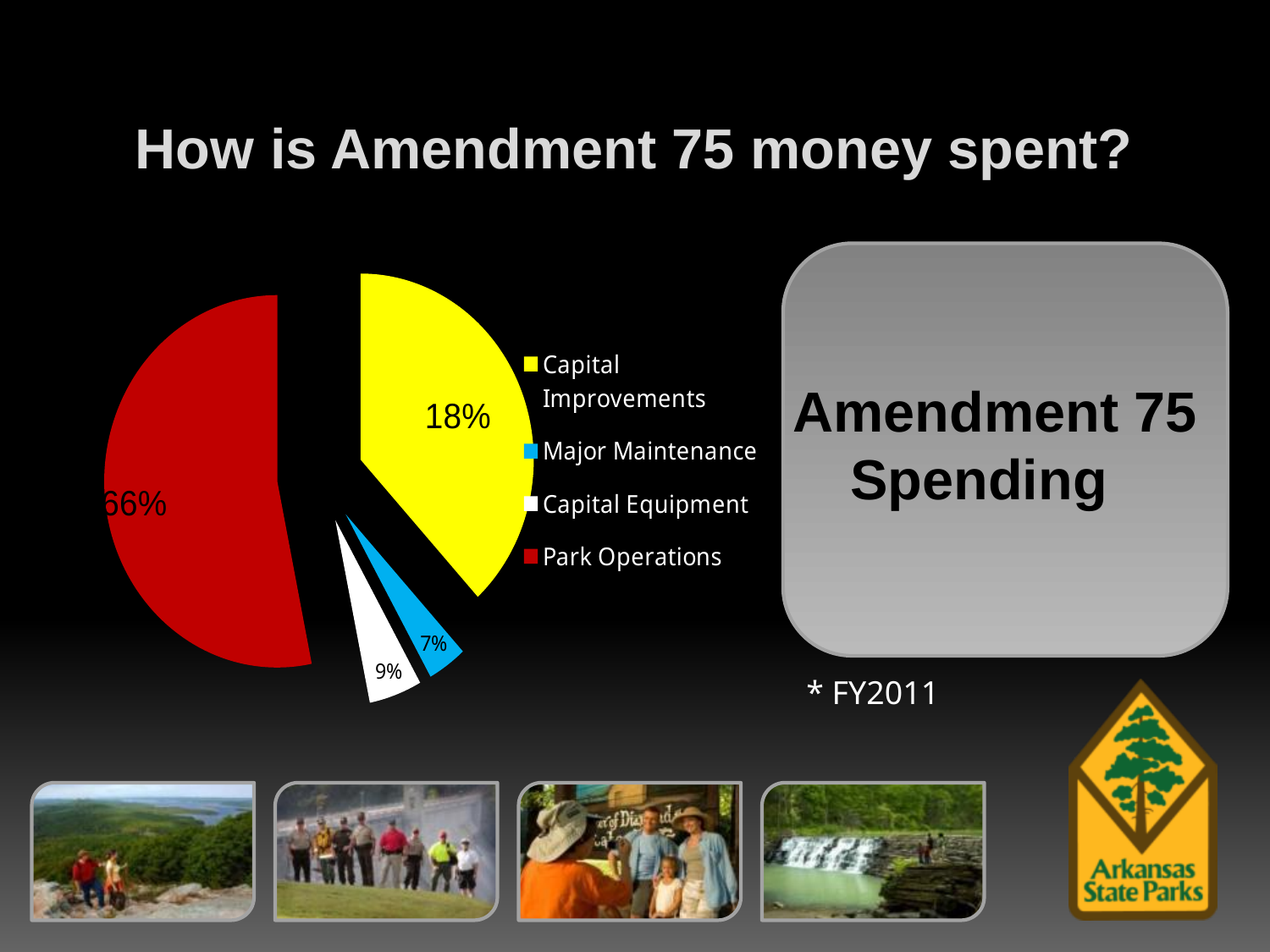
What share of Amendment 75 spending goes to Capital Improvements? 18% What share of Amendment 75 spending goes to Major Maintenance? 7% What kind of chart is shown on the slide? pie chart How many categories does the pie chart show? 4 Which fiscal year does the chart's footnote refer to? FY2011 What colour is the Park Operations slice of the pie chart? red Which category receives the largest share of Amendment 75 spending? Park Operations What share of Amendment 75 spending goes to Park Operations? 66% Which is larger, the share for Capital Equipment or the share for Major Maintenance? Capital Equipment Which category receives the smallest share of Amendment 75 spending? Major Maintenance How many percentage points larger is the Park Operations share than the Capital Improvements share? 48 What share of Amendment 75 spending goes to Capital Equipment? 9%